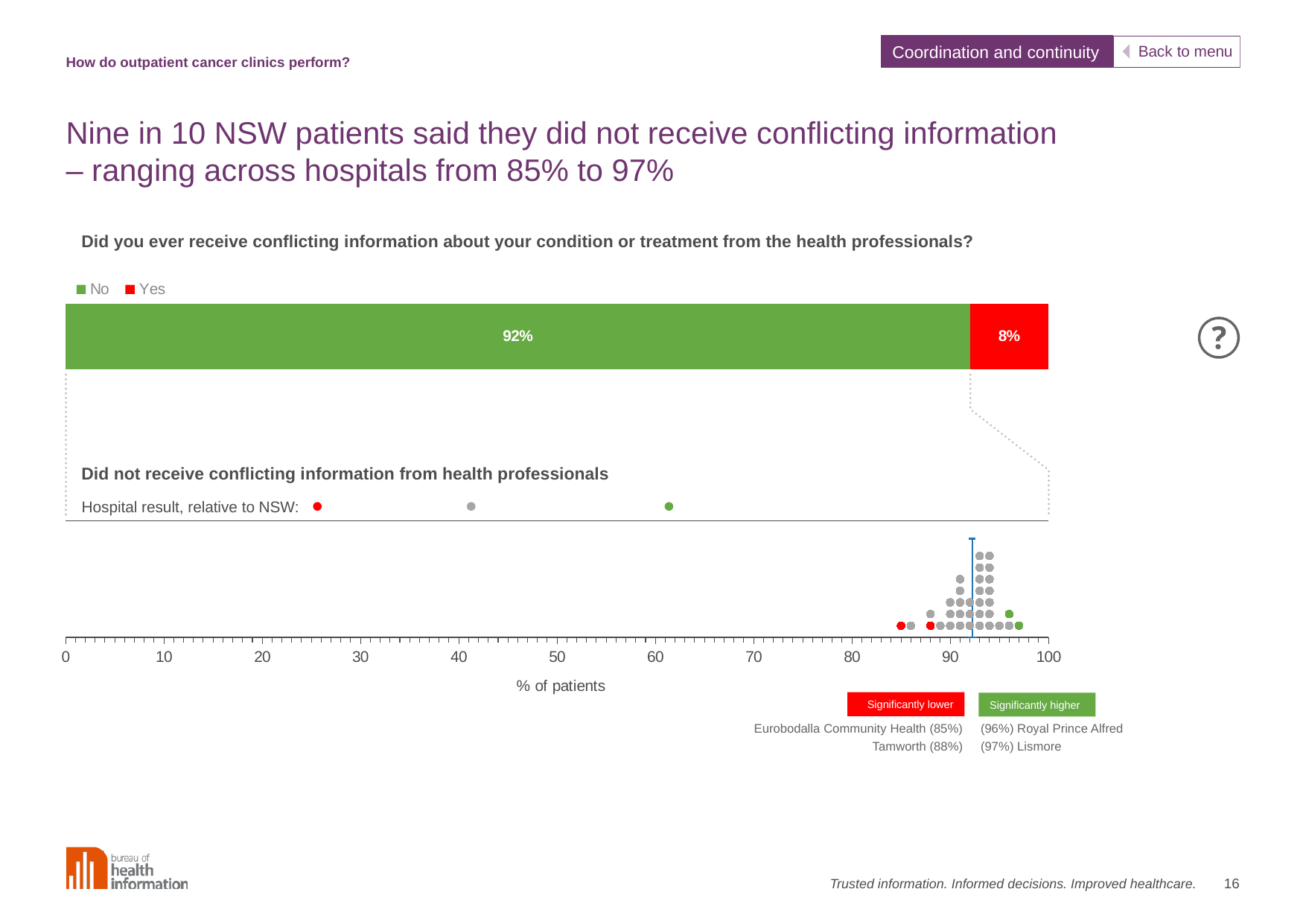
What kind of chart shows the 92% and 8% values? Bar chart In the stacked bar chart, what is the total of the 'No' and 'Yes' segments? 100% What is the label on the x axis of the hospital dot plot? % of patients In the stacked bar chart, what percentage of NSW patients answered 'Yes'? 8% In the stacked bar chart, which is larger, the 'No' segment or the 'Yes' segment? No How many series does the legend of the stacked bar chart list? 2 In the stacked bar chart, what is the difference between the 'No' and 'Yes' percentages? 84 percentage points In the hospital dot plot, what is the difference between the Lismore result and the Eurobodalla Community Health result? 12 percentage points In the hospital dot plot, what is the result for Eurobodalla Community Health? 85% In the hospital dot plot, which hospital has the highest result? Lismore In the hospital dot plot, what is the result for Lismore? 97% In the stacked bar chart, what percentage of NSW patients answered 'No' to receiving conflicting information? 92%